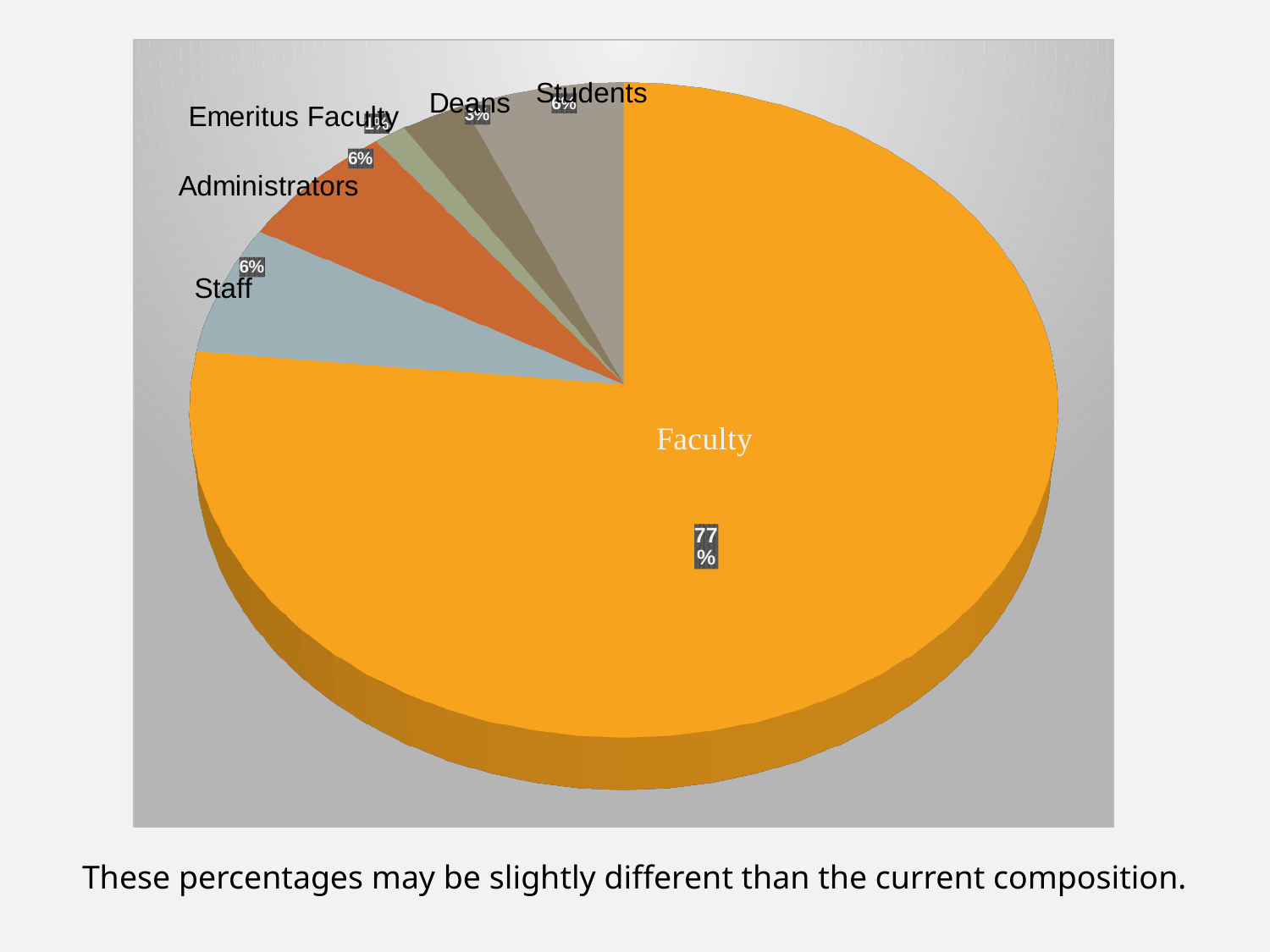
What kind of chart is shown on the slide? pie chart What percentage of the pie does the Faculty slice represent? 77% What is the value shown for Deans? 3% Which category has the largest slice of the pie? Faculty Which category has the smallest slice of the pie? Emeritus Faculty Which is larger, the Faculty slice or the Students slice? Faculty What is the difference between the Faculty share and the Staff share? 71% What is the value shown for Students? 6% How many slices does the pie chart have? 6 What is the value shown for Administrators? 6% What note is written below the chart? These percentages may be slightly different than the current composition. What is the value shown for Staff? 6%